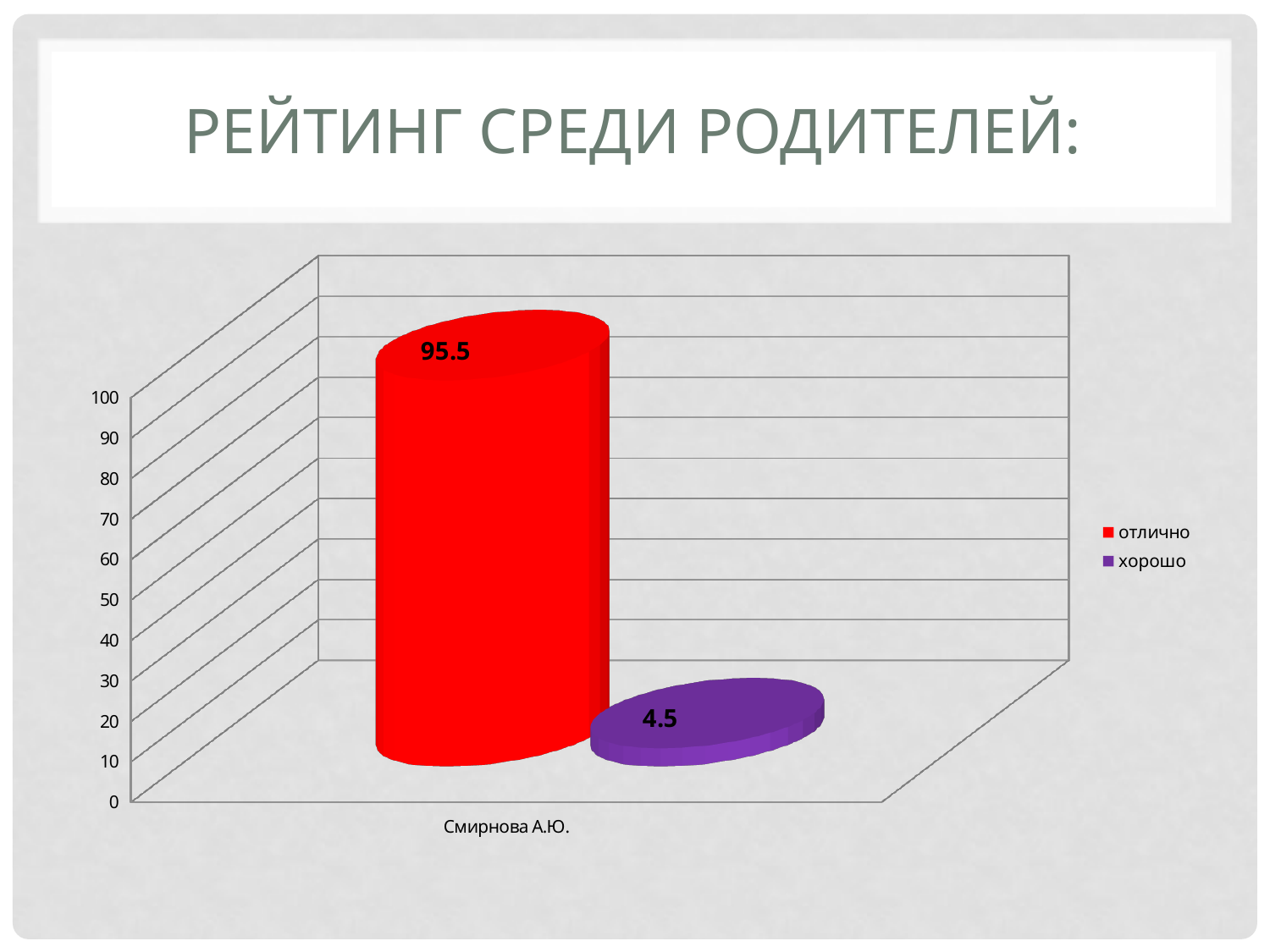
How many categories are shown on the x axis? 1 What is the title of the slide? РЕЙТИНГ СРЕДИ РОДИТЕЛЕЙ: Which series has the higher value, "отлично" or "хорошо"? отлично How many series does the legend list? 2 Is the value for "отлично" greater or less than 90? greater What is the total of the "отлично" and "хорошо" values? 100 What is the value for "отлично" for Смирнова А.Ю.? 95.5 What is the difference between the "отлично" and "хорошо" values? 91 Which series has the lowest value on the chart? хорошо What is the value for "хорошо" for Смирнова А.Ю.? 4.5 What kind of chart is shown on the slide? bar chart Is the value for "хорошо" greater or less than 10? less